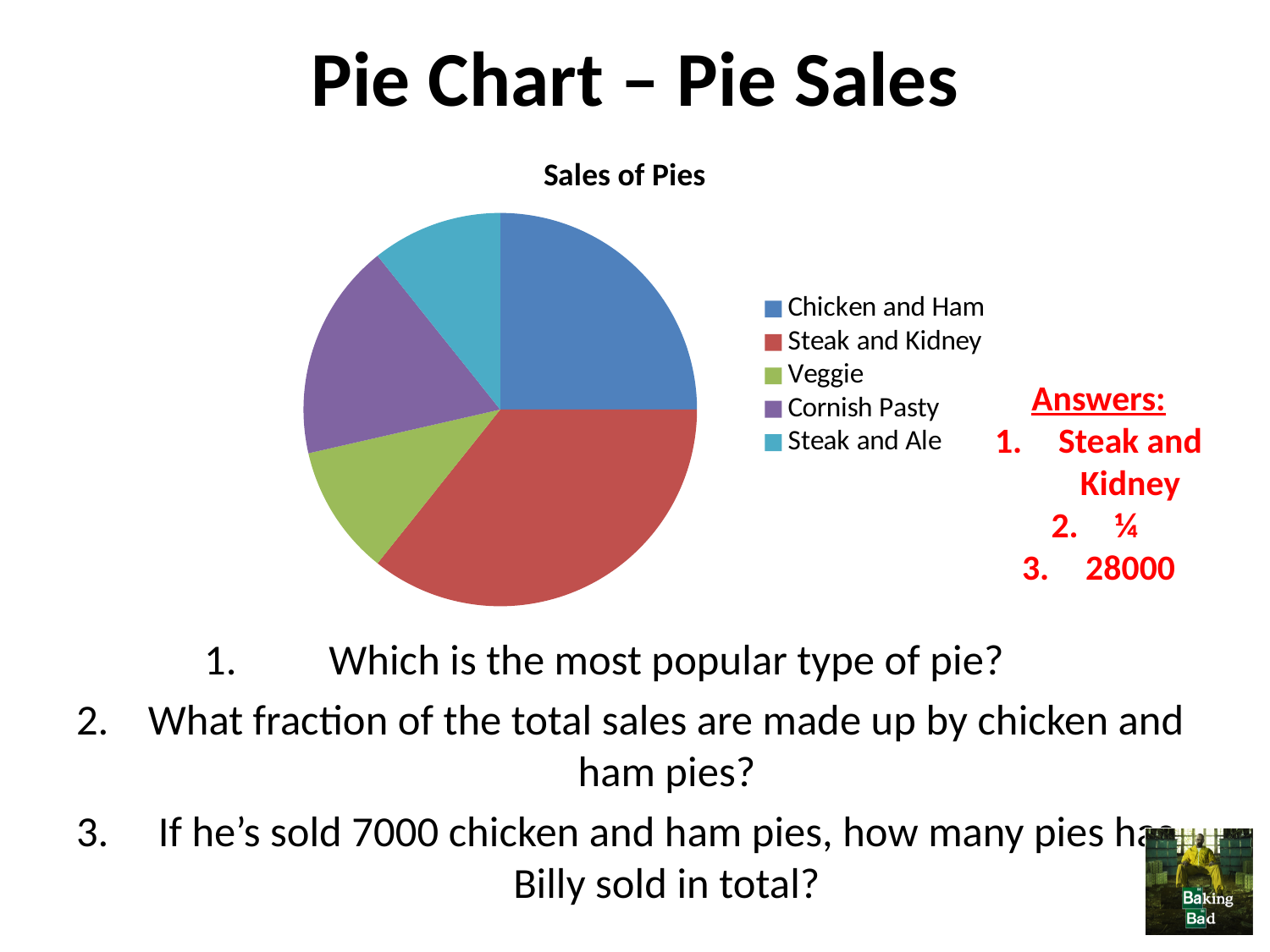
How many entries does the chart's legend list? 5 According to the slide, what fraction of total sales is made up by Chicken and Ham pies? ¼ Which pie type has the largest slice of the chart? Steak and Kidney Which slice is larger, Steak and Kidney or Chicken and Ham? Steak and Kidney What colour is the Steak and Kidney slice? red What is the title of the chart? Sales of Pies Which slice is larger, Steak and Kidney or Cornish Pasty? Steak and Kidney Which slice is larger, Cornish Pasty or Veggie? Cornish Pasty How many pie types (slices) does the chart show? 5 What kind of chart is shown on the slide? pie chart